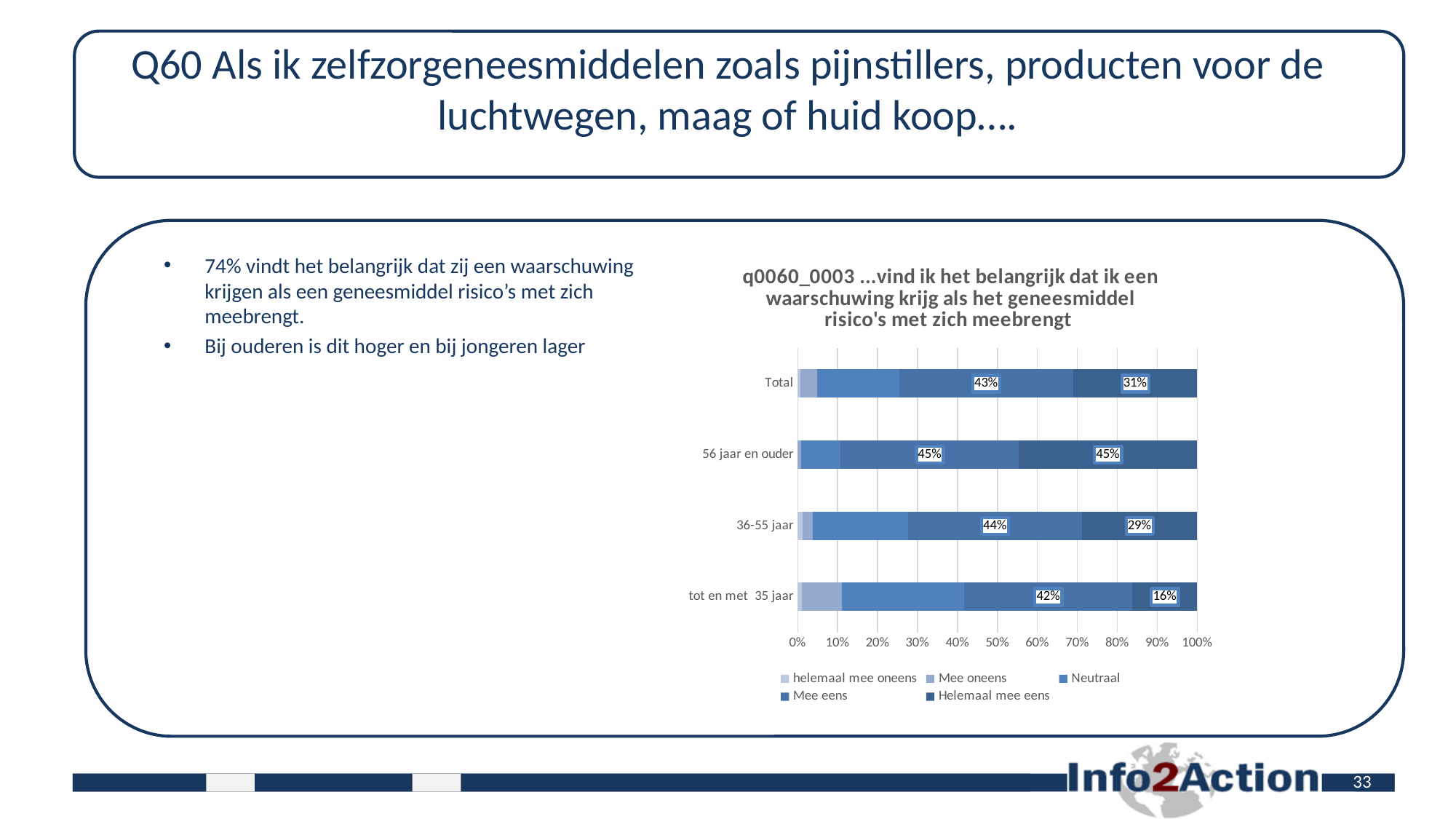
How many categories (bars) are shown in the chart? 4 What is the 'Helemaal mee eens' value for tot en met 35 jaar? 16% What is the 'Helemaal mee eens' value for 56 jaar en ouder? 45% Is the 'Neutraal' value for tot en met 35 jaar greater or less than 20%? greater Which is larger: the 'Helemaal mee eens' value for 36-55 jaar or for tot en met 35 jaar? 36-55 jaar Which category has the lowest 'Helemaal mee eens' value? tot en met 35 jaar What kind of chart is shown on the slide? Stacked bar chart What is the 'Mee eens' value for 36-55 jaar? 44% What is the difference between the 'Mee eens' and 'Helemaal mee eens' values for Total? 12 percentage points What is the 'Mee eens' value for Total? 43% Which age group has the highest 'Helemaal mee eens' value? 56 jaar en ouder How many series does the legend list? 5